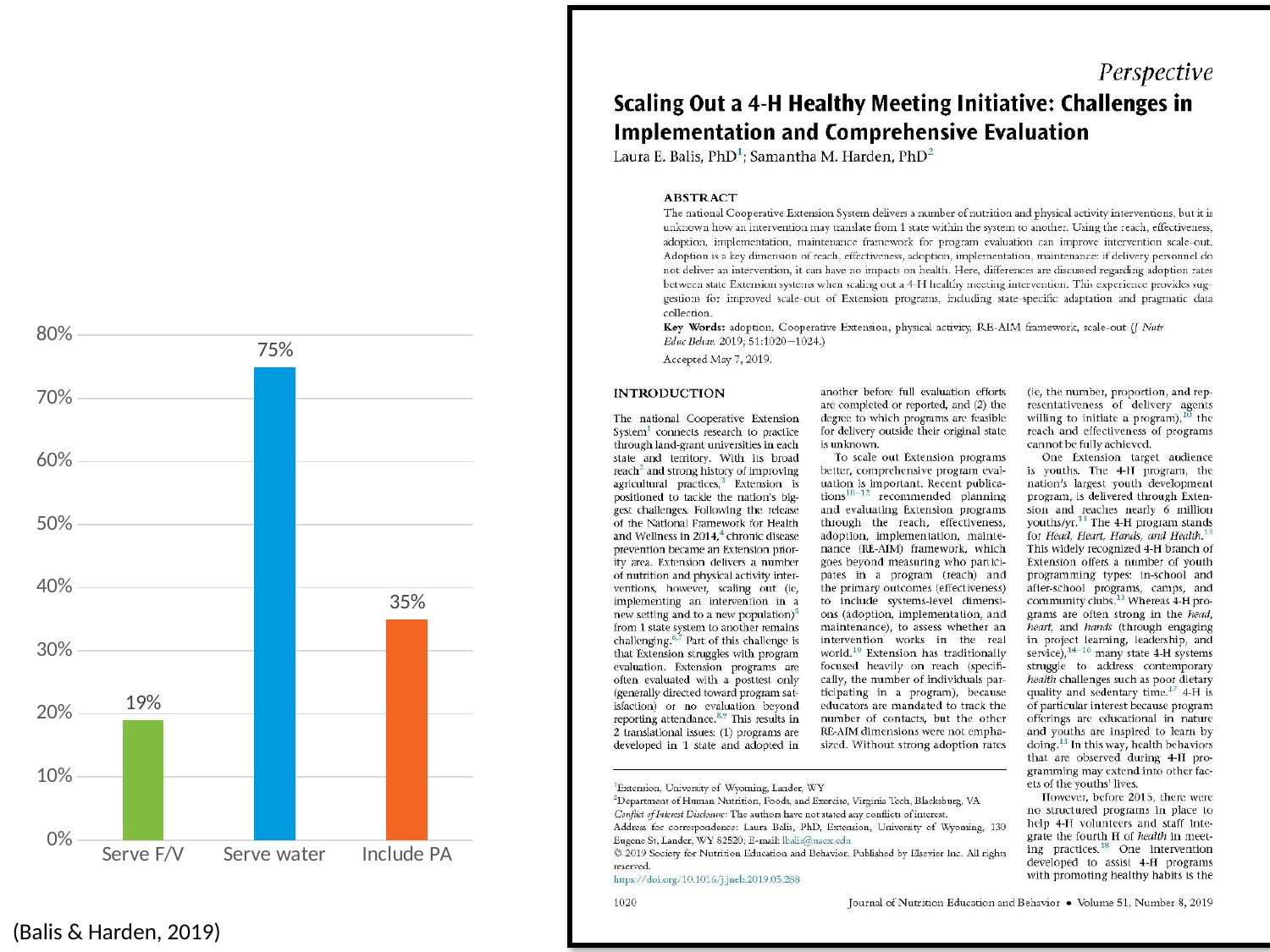
What is the difference between the values for Serve water and Include PA? 40% How many categories are shown on the chart? 3 What is the value for Serve F/V? 19% What is the value for Serve water? 75% Which category has the lowest value? Serve F/V Which category has the highest value? Serve water What is the difference between the values for Include PA and Serve F/V? 16% Which is larger, the value for Serve F/V or the value for Include PA? Include PA Is the value for Serve water greater or less than 70%? greater What kind of chart is shown on the slide? bar chart What is the value for Include PA? 35% What colour is the bar for Serve water? blue